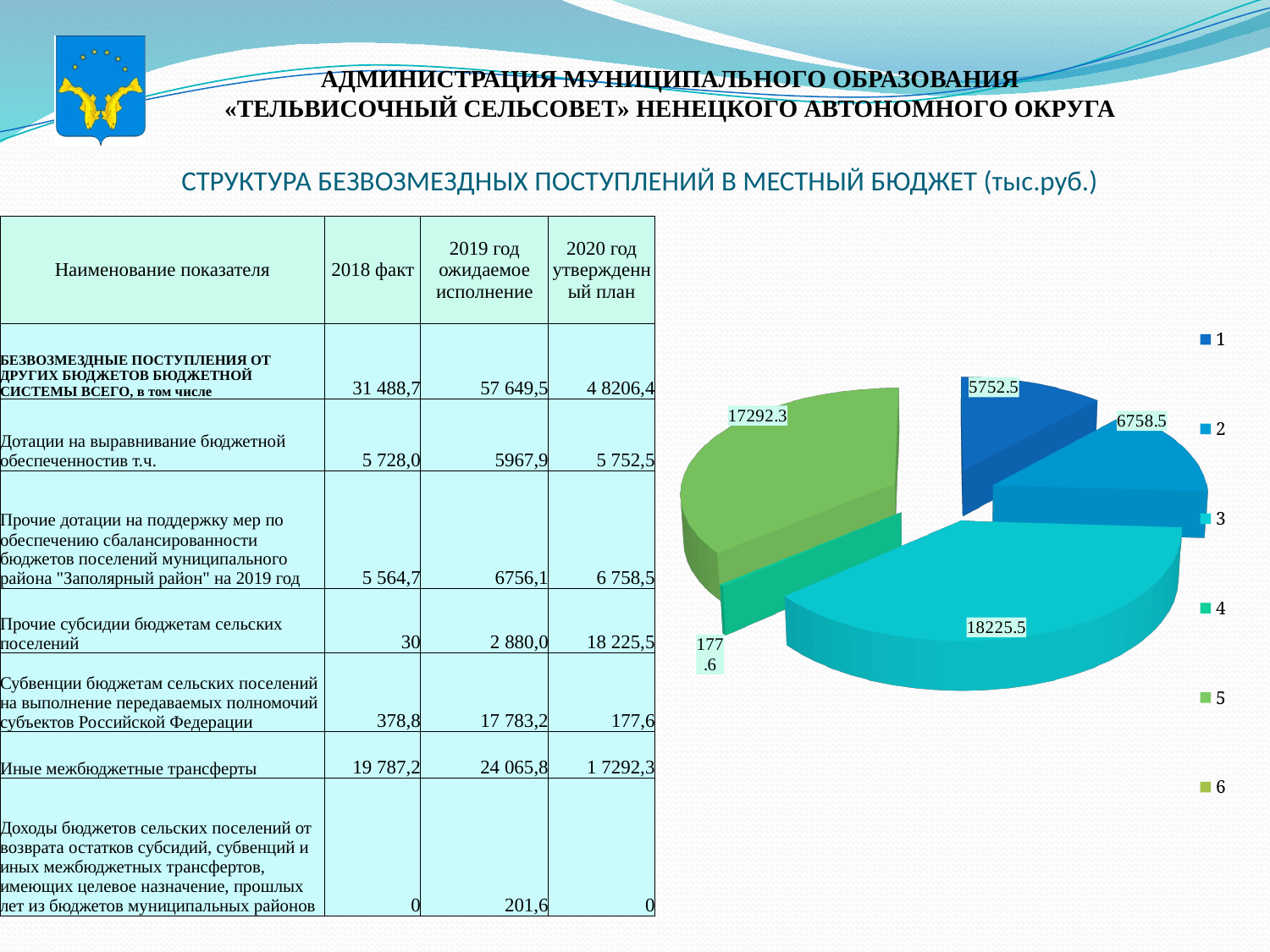
What is the difference between the slices labelled 18225.5 and 17292.3 in the pie chart? 933.2 What is the title of the slide above the table and pie chart? СТРУКТУРА БЕЗВОЗМЕЗДНЫХ ПОСТУПЛЕНИЙ В МЕСТНЫЙ БЮДЖЕТ (тыс.руб.) What is the value of the largest slice of the pie chart? 18225.5 What value is printed on the slice for legend entry 2 of the pie chart? 6758.5 What kind of chart is shown on the right side of the slide? pie chart What is the difference between the slices labelled 6758.5 and 5752.5 in the pie chart? 1006 What value is printed on the green slice (legend entry 5) of the pie chart? 17292.3 Which is larger in the pie chart: the slice labelled 18225.5 or the slice labelled 17292.3? 18225.5 How many data labels are printed on the pie chart? 5 What value is printed on the dark blue slice (legend entry 1) of the pie chart? 5752.5 What is the value of the smallest labelled slice of the pie chart? 177.6 How many entries does the legend of the pie chart list? 6